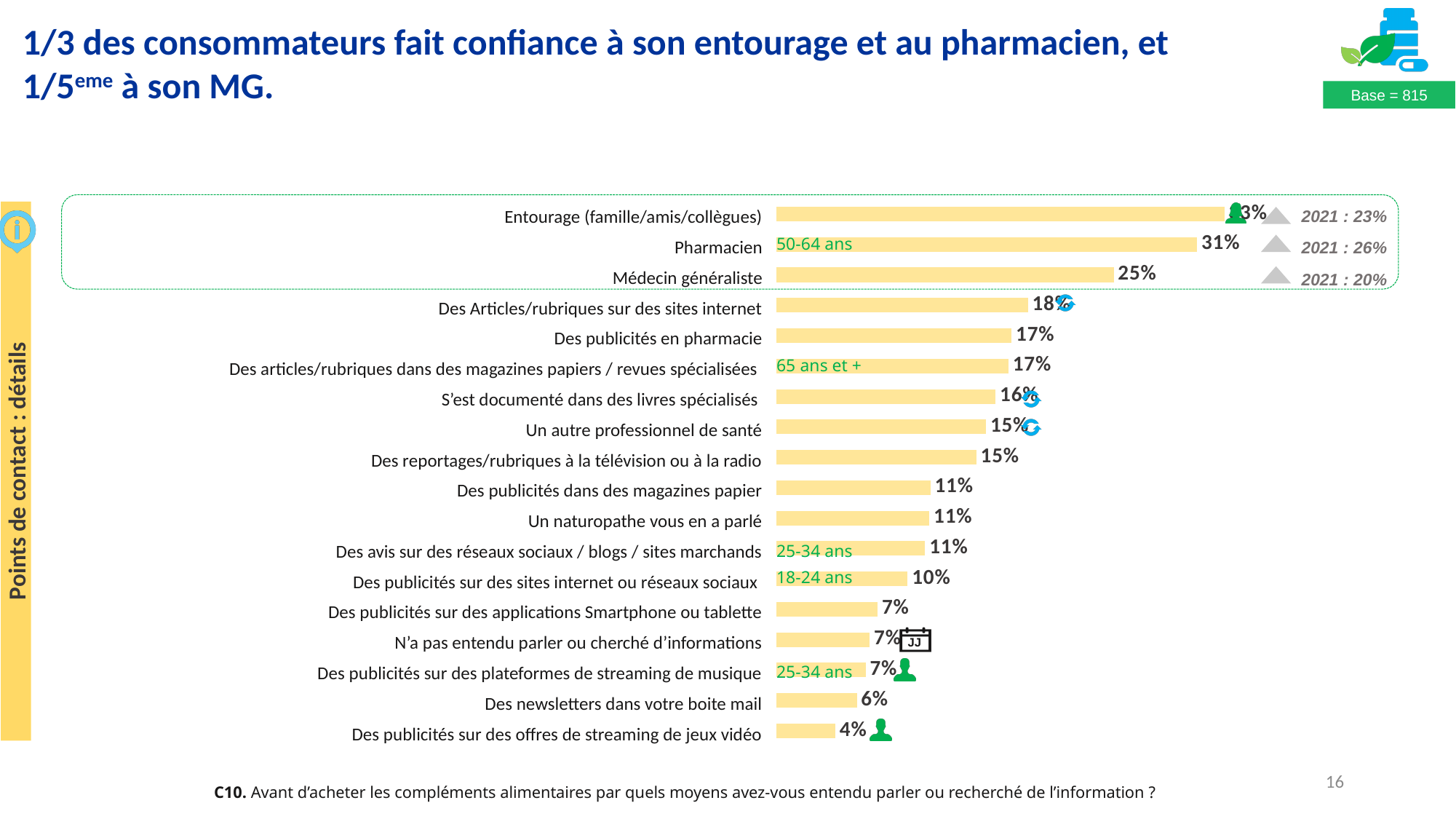
What is the value for Des newsletters dans votre boite mail? 6% Which category has the lowest value? Des publicités sur des offres de streaming de jeux vidéo What is the difference between the values for Pharmacien and Médecin généraliste? 6 percentage points What is the value for Médecin généraliste? 25% Which is larger, the value for Des publicités en pharmacie or the value for Des publicités dans des magazines papier? Des publicités en pharmacie What is the value for Des publicités sur des offres de streaming de jeux vidéo? 4% What is the value for Des Articles/rubriques sur des sites internet? 18% What kind of chart is shown on the slide? Bar chart Which category has the highest value? Entourage (famille/amis/collègues) What was the 2021 value shown next to Pharmacien? 26% What is the value for Pharmacien? 31% How many categories are shown in the chart? 18